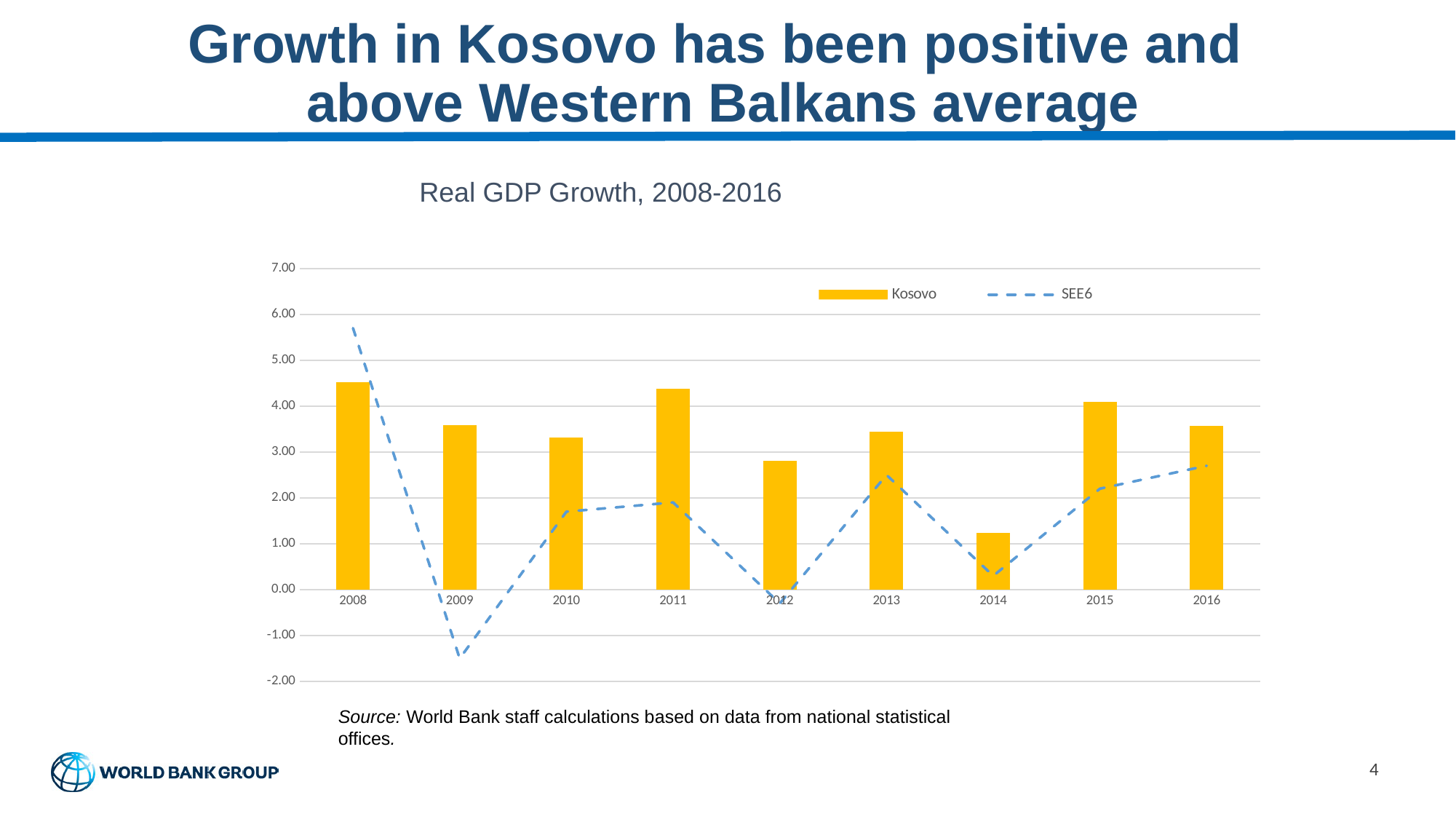
In which year is the SEE6 value highest? 2008 Which series is drawn as a dashed line? SEE6 Is the SEE6 value for 2008 greater or less than 5.00? greater Is the Kosovo value for 2014 greater or less than 2.00? less Is the SEE6 value for 2009 greater or less than -1.00? less Which is larger for Kosovo, the value for 2015 or the value for 2016? 2015 How many years are shown on the x axis? 9 In 2009, which series has the larger value, Kosovo or SEE6? Kosovo How many series does the legend list? 2 In which year is the SEE6 value lowest? 2009 What is the title of the chart? Real GDP Growth, 2008-2016 In which year is the Kosovo bar lowest? 2014